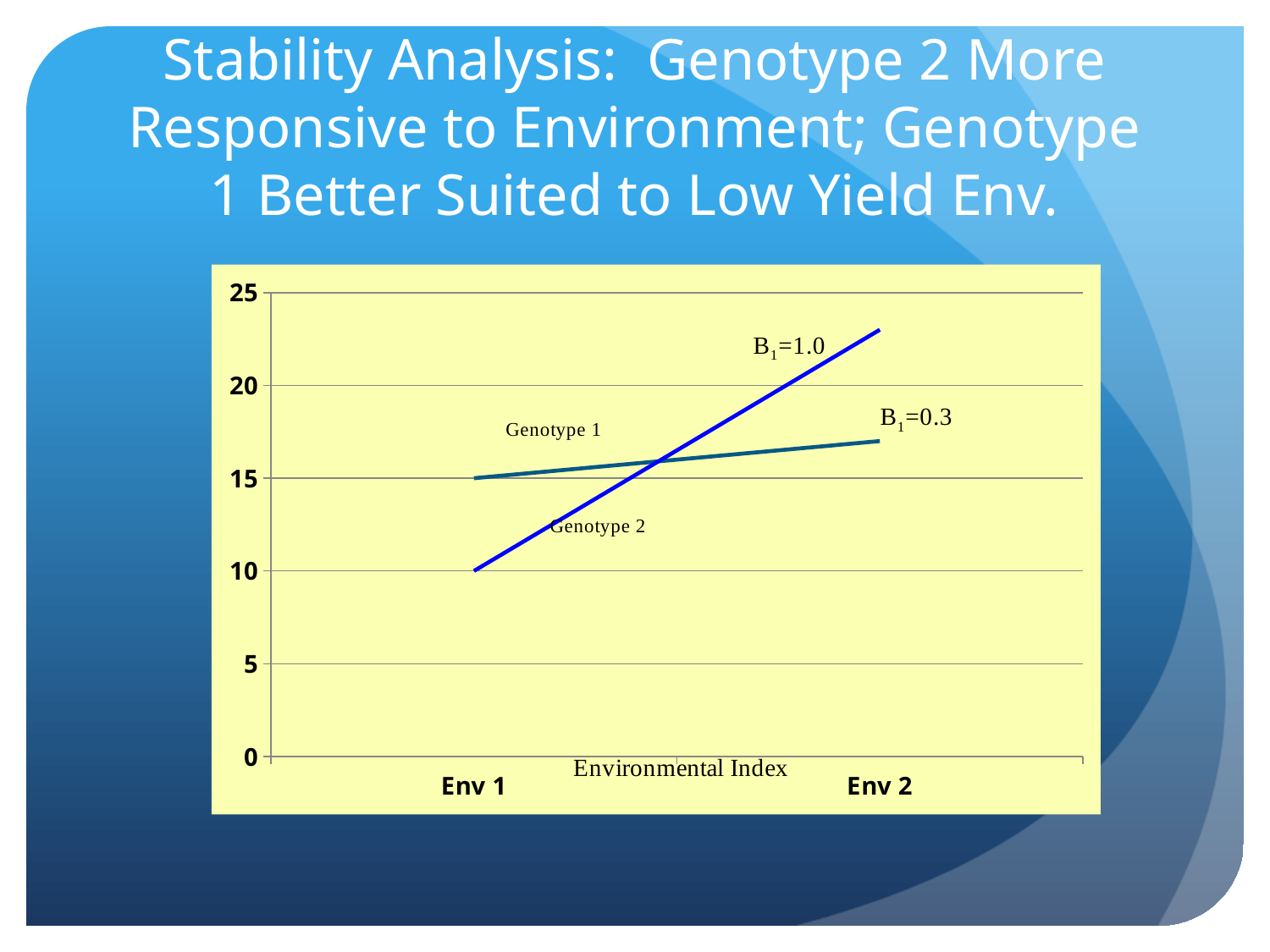
Is the value for Genotype 2 at Env 2 greater or less than 20? greater Which genotype has the higher value at Env 1? Genotype 1 Is the value for Genotype 1 at Env 2 greater or less than 20? less What is the value for Genotype 1 at Env 1? 15 What is the value for Genotype 2 at Env 1? 10 Is the value for Genotype 1 at Env 2 greater or less than 15? greater Does the line for Genotype 2 rise or fall from Env 1 to Env 2? rise How many environments are shown on the x axis? 2 What is the difference between Genotype 1 and Genotype 2 at Env 1? 5 What is the B1 value labelled next to the Genotype 1 line? B1=0.3 Which genotype has the higher value at Env 2? Genotype 2 What type of chart is shown on the slide? line chart